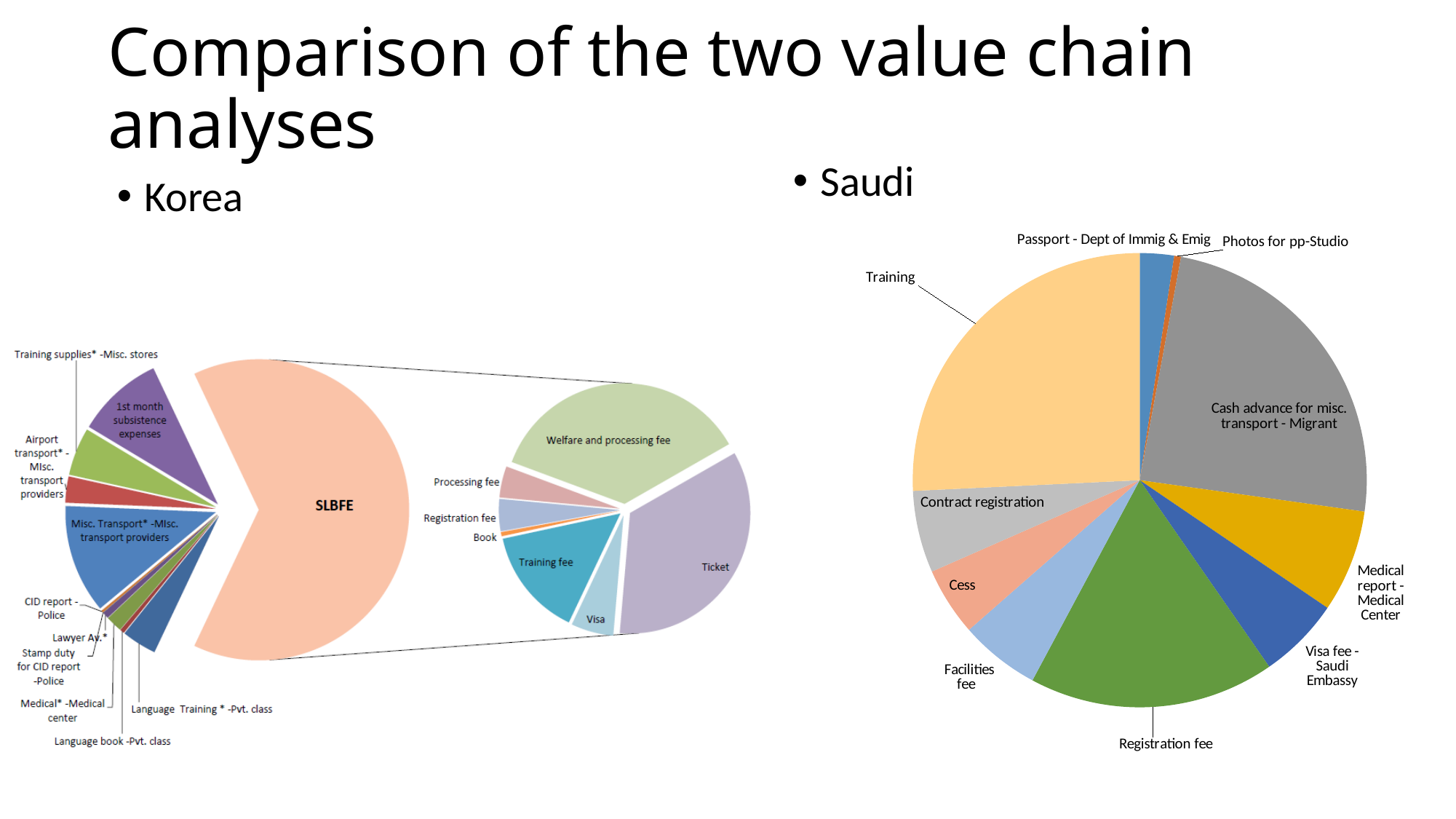
In the Korea chart, how many slices does the SLBFE breakdown pie on the right have? 7 In the Saudi pie chart, which slice is the smallest? Photos for pp-Studio What kind of chart is the Korea chart on the left of the slide? pie chart In the Saudi pie chart, which is larger: Passport - Dept of Immig & Emig or Photos for pp-Studio? Passport - Dept of Immig & Emig In the Korea chart, which slice of the SLBFE breakdown pie is the smallest? Book In the Korea chart, which is larger in the SLBFE breakdown: Welfare and processing fee or Processing fee? Welfare and processing fee In the Saudi pie chart, which is larger: Cash advance for misc. transport - Migrant or Cess? Cash advance for misc. transport - Migrant In the Saudi pie chart, how many slices are labelled? 10 What kind of chart is the Saudi chart on the right of the slide? pie chart In the Korea chart, which slice of the SLBFE breakdown pie is the largest? Ticket In the Korea chart, what is the label of the large central pie slice that is broken down into the smaller pie on the right? SLBFE